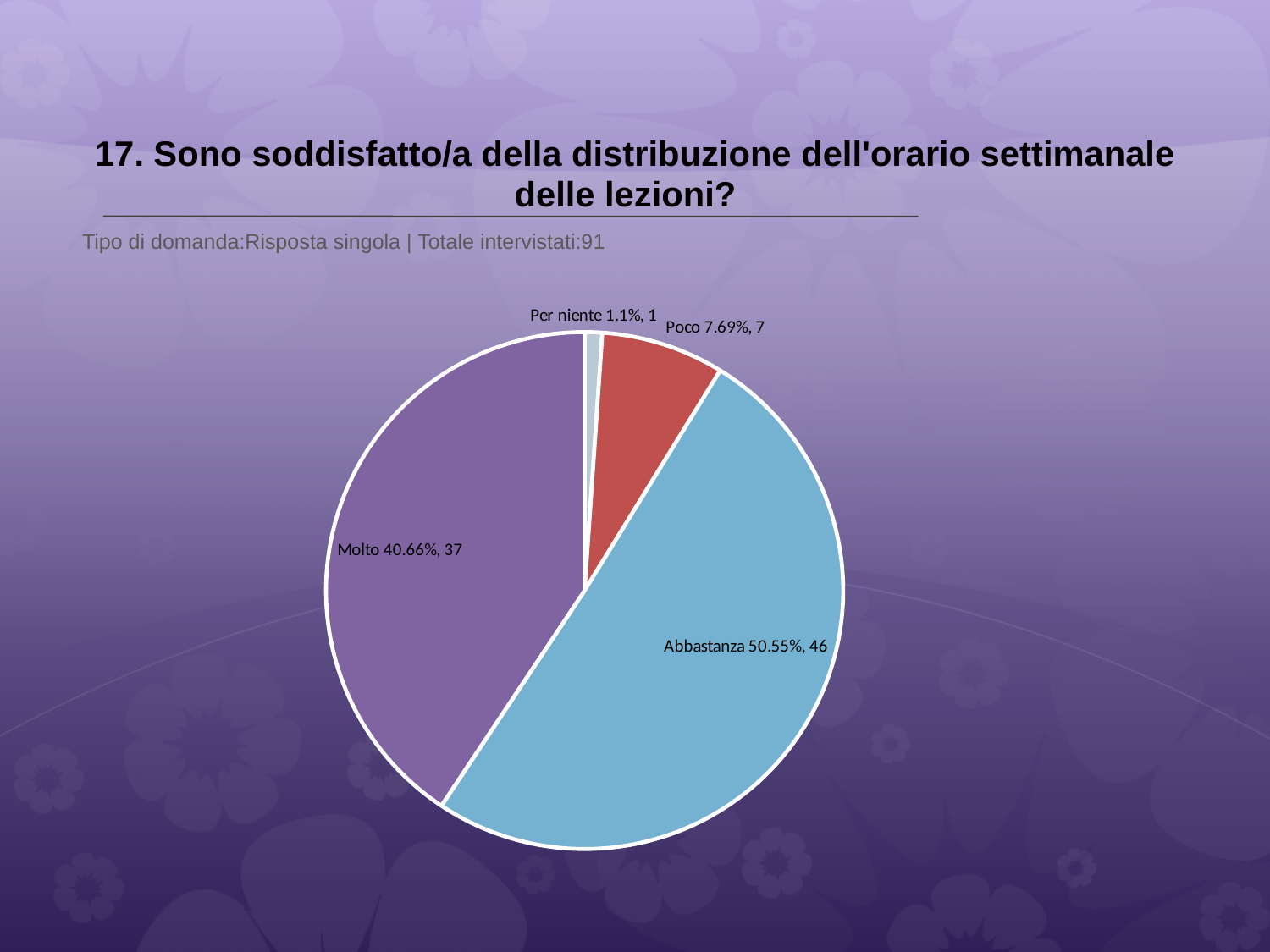
What percentage share does the 'Abbastanza' slice have? 50.55% What percentage share does the 'Per niente' slice have? 1.1% How many slices does the pie chart have? 4 How many respondents answered 'Poco'? 7 What is the difference in respondent count between 'Abbastanza' and 'Molto'? 9 How many respondents answered 'Molto'? 37 Which category has the smallest slice? Per niente Which has more respondents, 'Poco' or 'Per niente'? Poco What colour is the 'Molto' slice? purple What kind of chart is shown on the slide? pie chart Which category has the largest slice? Abbastanza What is the total number of respondents stated on the slide? 91